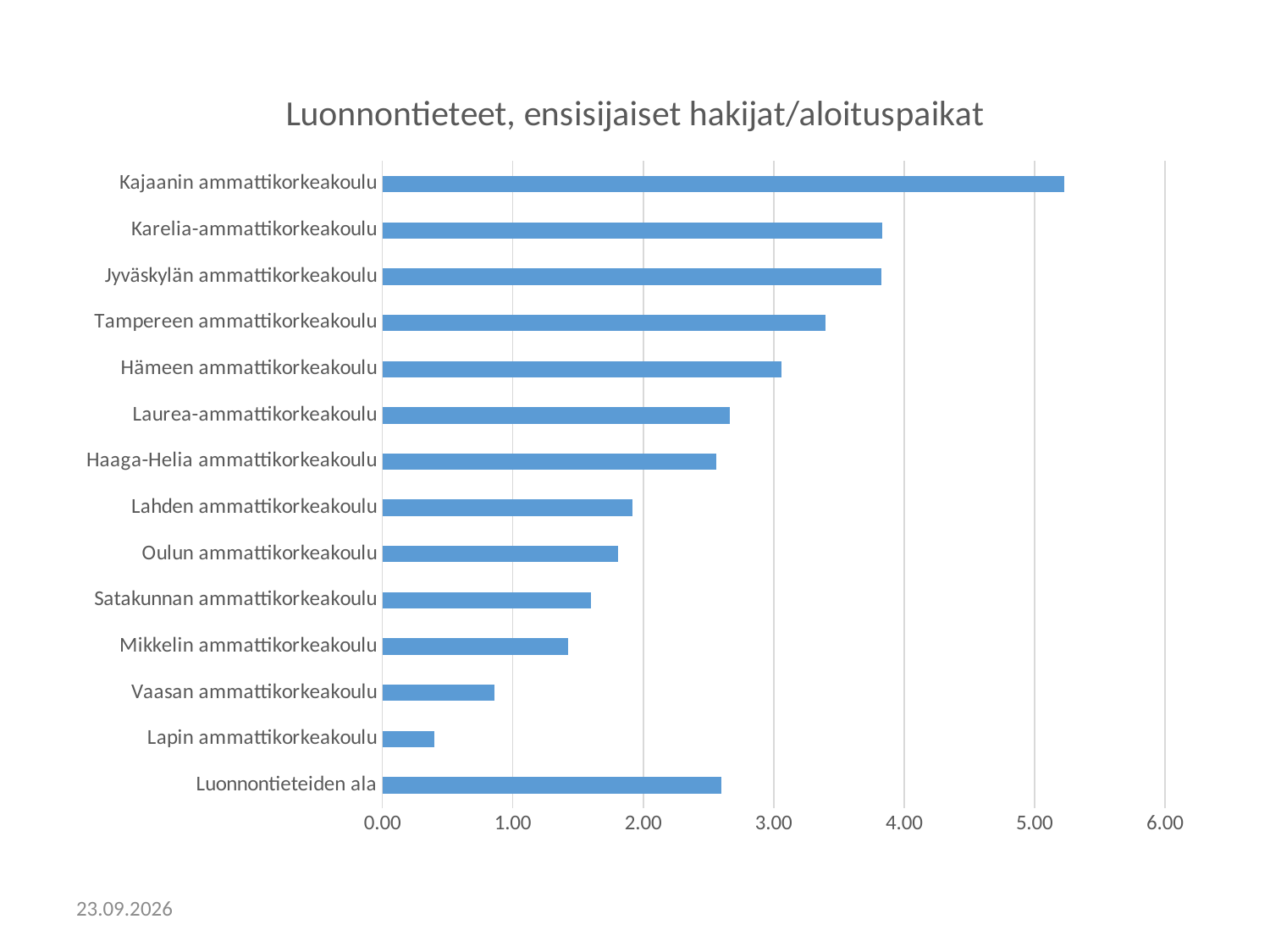
Which has a larger value, Mikkelin ammattikorkeakoulu or Vaasan ammattikorkeakoulu? Mikkelin ammattikorkeakoulu How many categories are plotted in the chart? 14 Is the value for Kajaanin ammattikorkeakoulu greater or less than 5.00? greater Is the value for Tampereen ammattikorkeakoulu greater or less than 3.00? greater Which category has the lowest value? Lapin ammattikorkeakoulu Which category has the highest value? Kajaanin ammattikorkeakoulu Is the value for Lapin ammattikorkeakoulu greater or less than 1.00? less What is the title of the chart? Luonnontieteet, ensisijaiset hakijat/aloituspaikat What type of chart is shown on the slide? bar chart Which has a larger value, Tampereen ammattikorkeakoulu or Laurea-ammattikorkeakoulu? Tampereen ammattikorkeakoulu